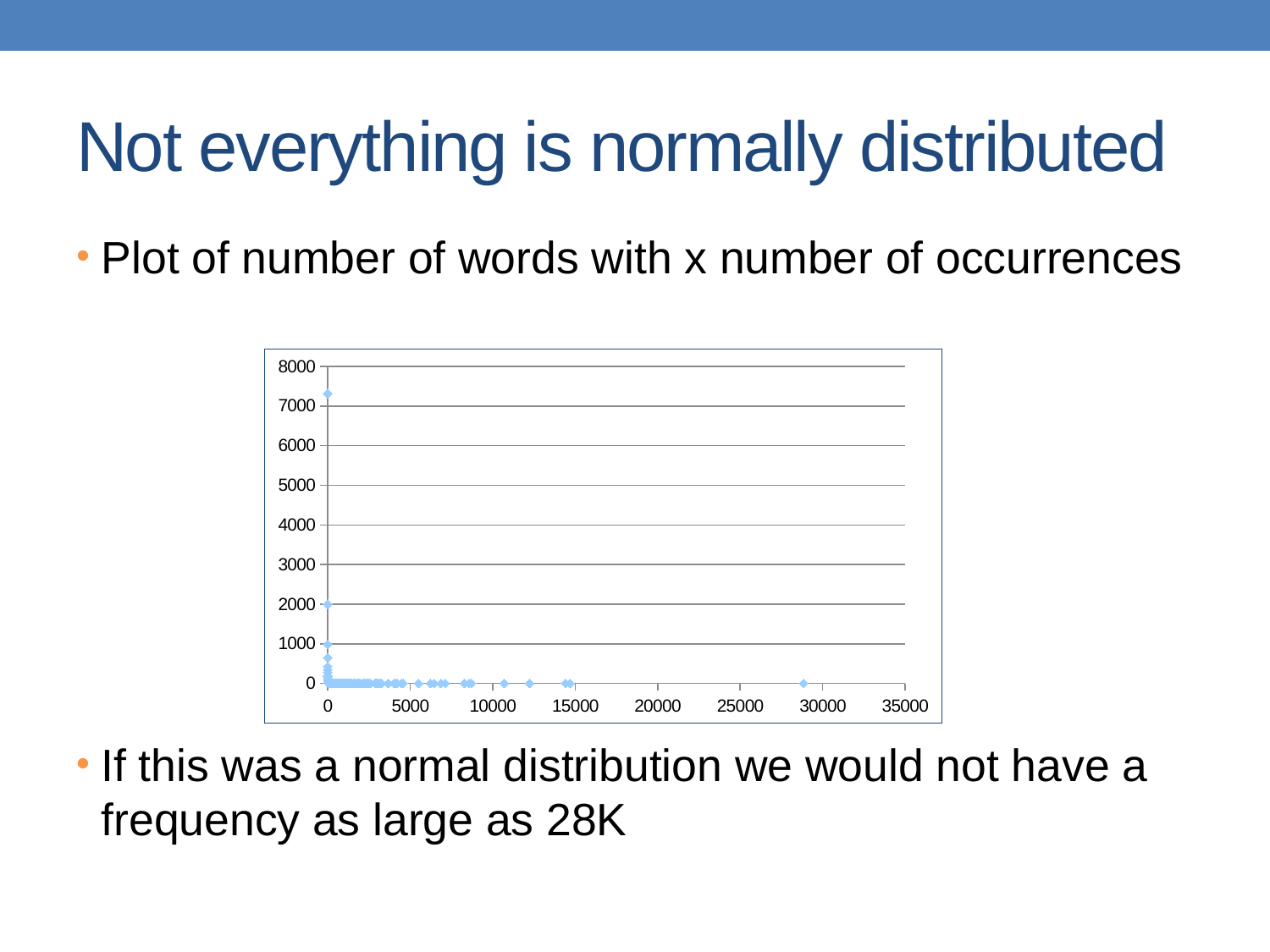
Is the x value of the rightmost point on the chart greater or less than 30000? less What is the largest value labelled on the x axis of the chart? 35000 Is the highest point on the chart greater or less than 7000 on the y axis? greater What kind of chart is shown on the slide? scatter plot Is the highest point on the chart greater or less than 8000 on the y axis? less What is the largest value labelled on the y axis of the chart? 8000 Do the plotted y values generally rise or fall as x increases along the x axis? fall